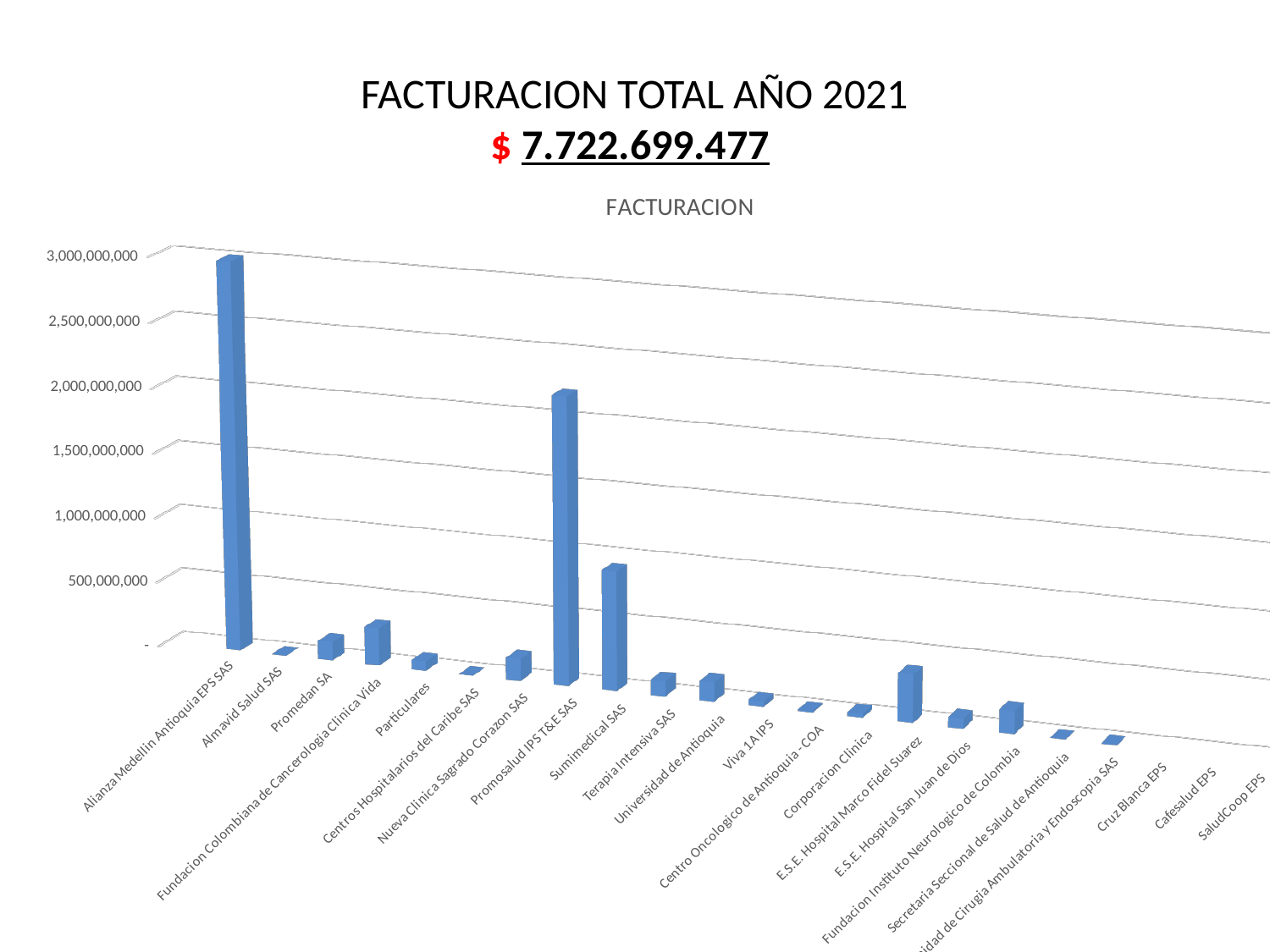
What kind of chart is shown on the slide? bar chart How many categories are plotted on the x axis of the chart? 22 Is the value for Alianza Medellin Antioquia EPS SAS greater or less than 2,500,000,000? greater Which category has the second-highest value in the chart? Promosalud IPS T&E SAS What total billing amount for 2021 is printed above the chart? $ 7.722.699.477 Which is larger, the value for Alianza Medellin Antioquia EPS SAS or the value for Promosalud IPS T&E SAS? Alianza Medellin Antioquia EPS SAS Which is larger, the value for E.S.E. Hospital Marco Fidel Suarez or the value for Corporacion Clinica? E.S.E. Hospital Marco Fidel Suarez Is the value for Sumimedical SAS greater or less than 1,000,000,000? less Which is larger, the value for Promosalud IPS T&E SAS or the value for Sumimedical SAS? Promosalud IPS T&E SAS Which category has the highest value in the chart? Alianza Medellin Antioquia EPS SAS What is the title of the chart? FACTURACION Is the value for Promosalud IPS T&E SAS greater or less than 1,500,000,000? greater